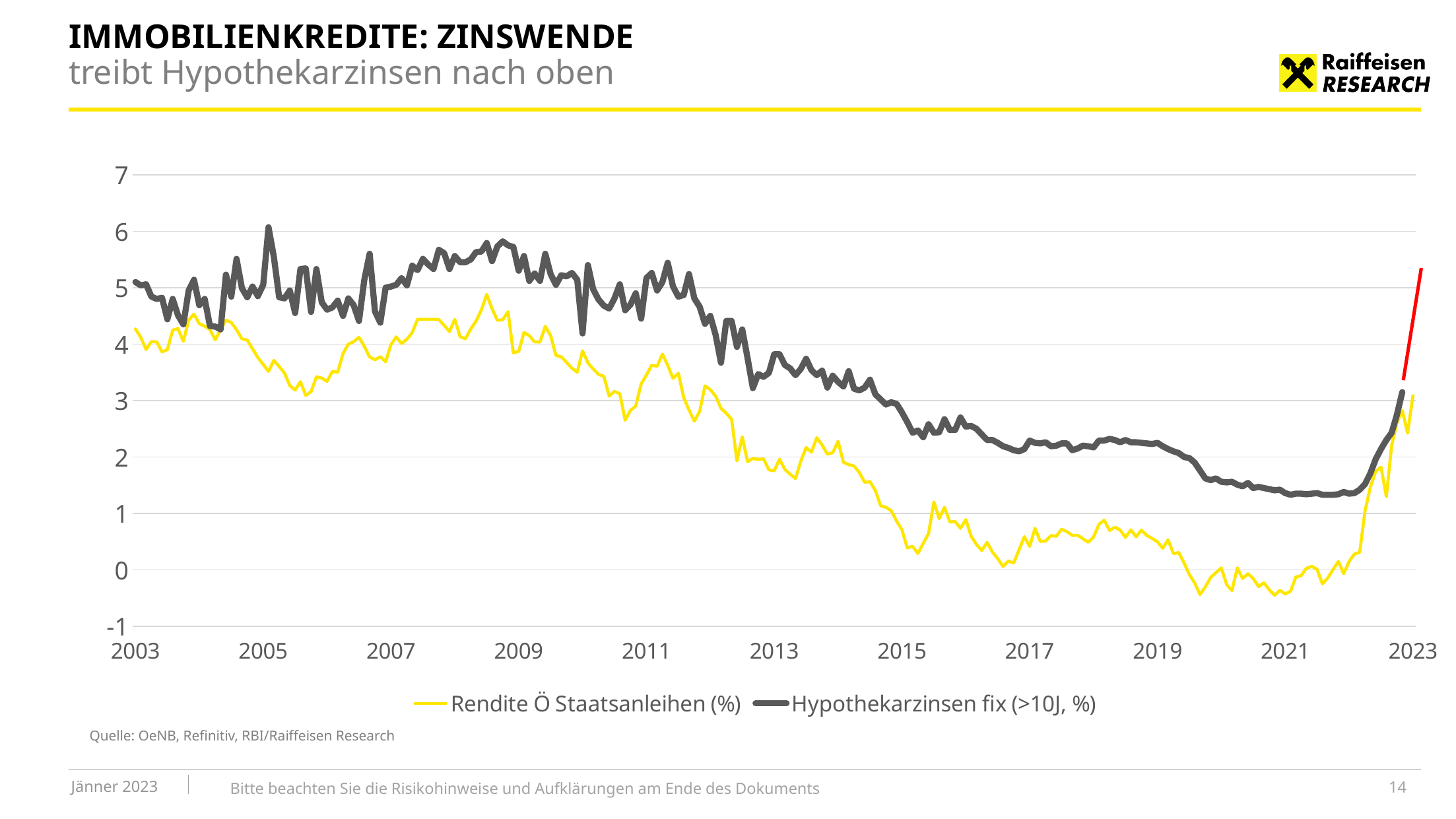
What kind of chart is shown on the slide? line chart Is the value of Hypothekarzinsen fix (>10J, %) higher in 2005 or in 2017? 2005 Is the value of Hypothekarzinsen fix (>10J, %) in 2005 greater or less than 4? greater Is the value of Rendite Ö Staatsanleihen (%) in 2020 greater or less than 1? less Is the value of Hypothekarzinsen fix (>10J, %) at the start of 2021 greater or less than 2? less How many series does the legend list? 2 Does Rendite Ö Staatsanleihen (%) rise or fall between 2021 and 2023? rise What is the first year shown on the x axis? 2003 What colour is the line for Rendite Ö Staatsanleihen (%)? yellow Does Hypothekarzinsen fix (>10J, %) rise or fall between 2009 and 2021? fall In 2009, which series has the higher value: Rendite Ö Staatsanleihen (%) or Hypothekarzinsen fix (>10J, %)? Hypothekarzinsen fix (>10J, %)